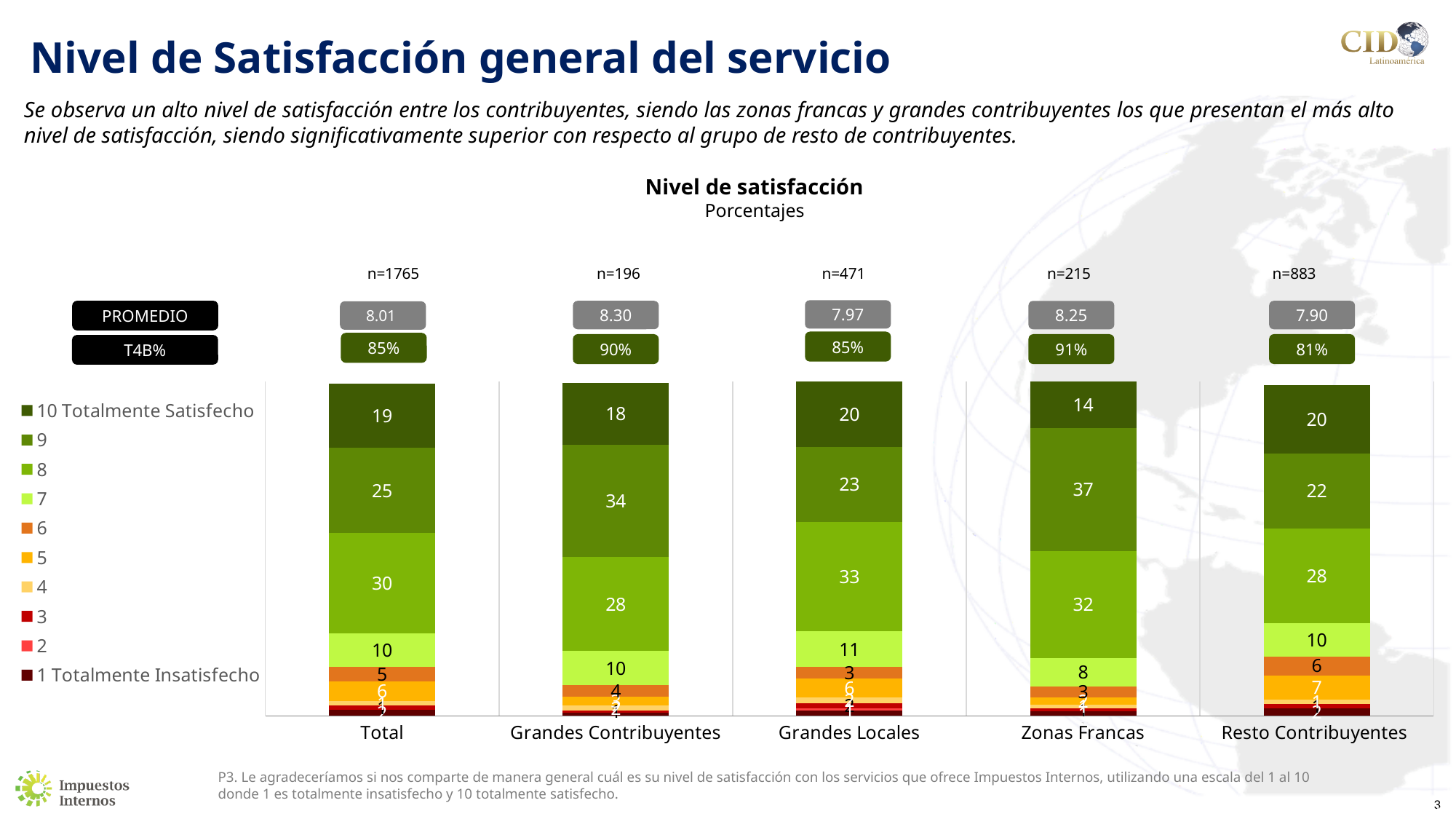
What is the value of the '9' segment for Zonas Francas? 37 What is the value of the '7' segment for Grandes Locales? 11 Which is larger: the '8' segment for Grandes Locales or the '8' segment for Resto Contribuyentes? Grandes Locales How many categories are shown along the x axis of the chart? 5 How many series does the chart legend list? 10 What is the value of the '10 Totalmente Satisfecho' segment for Grandes Locales? 20 Which category has the highest value for the '9' segment? Zonas Francas What is the value of the '8' segment for Total? 30 Which category has the lowest value for the '10 Totalmente Satisfecho' segment? Zonas Francas What is the difference between the '9' segment for Grandes Contribuyentes and the '9' segment for Total? 9 What type of chart is shown on the slide? stacked bar chart What is the title of the chart? Nivel de satisfacción